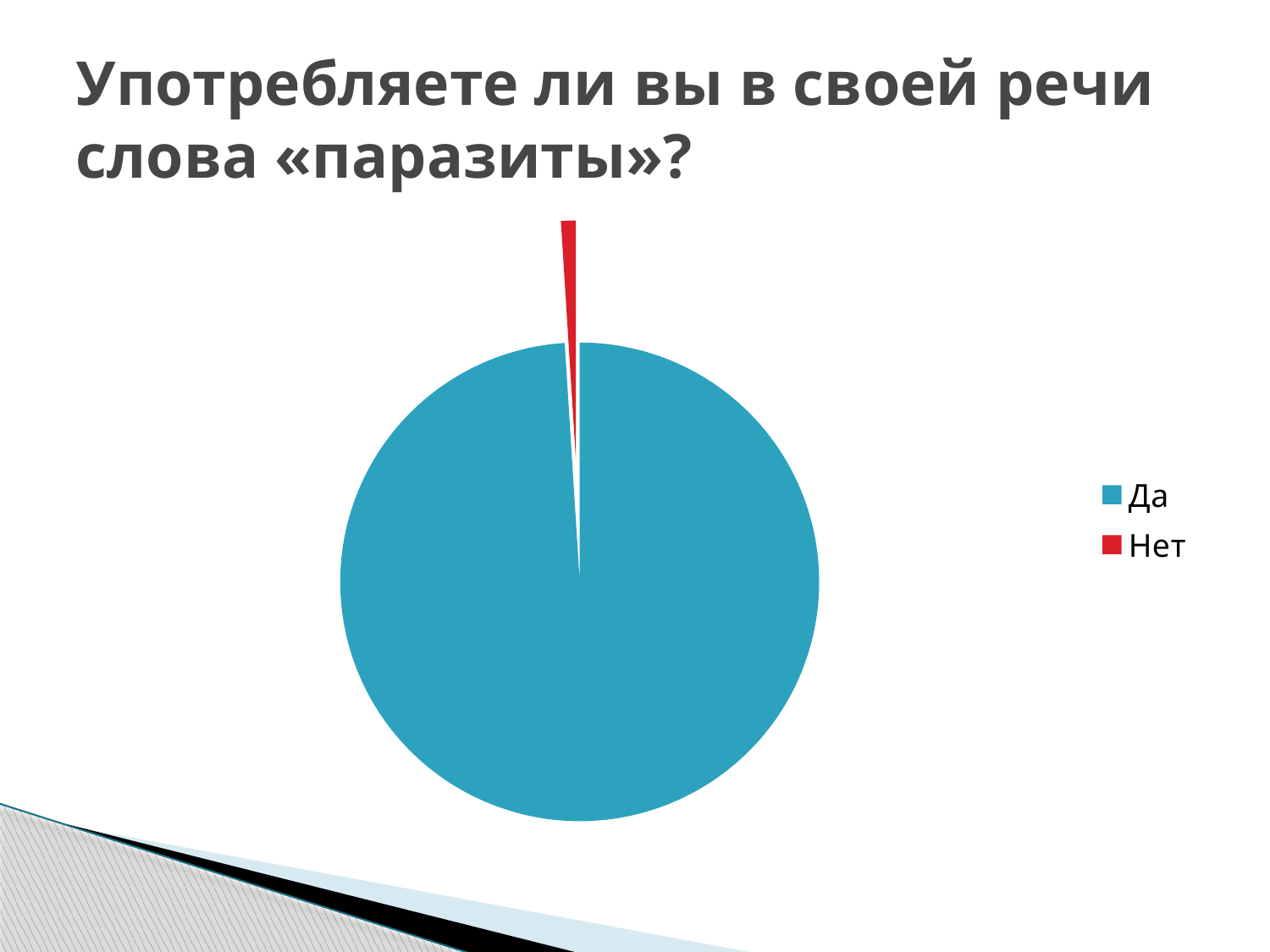
Which slice is larger, Да or Нет? Да How many slices does the pie chart have? 2 How many entries does the legend list? 2 What is the title of the chart on the slide? Употребляете ли вы в своей речи слова «паразиты»? Which category has the largest slice of the pie? Да What kind of chart is shown on the slide? pie chart What colour is the slice for Нет? red Which category has the smallest slice of the pie? Нет